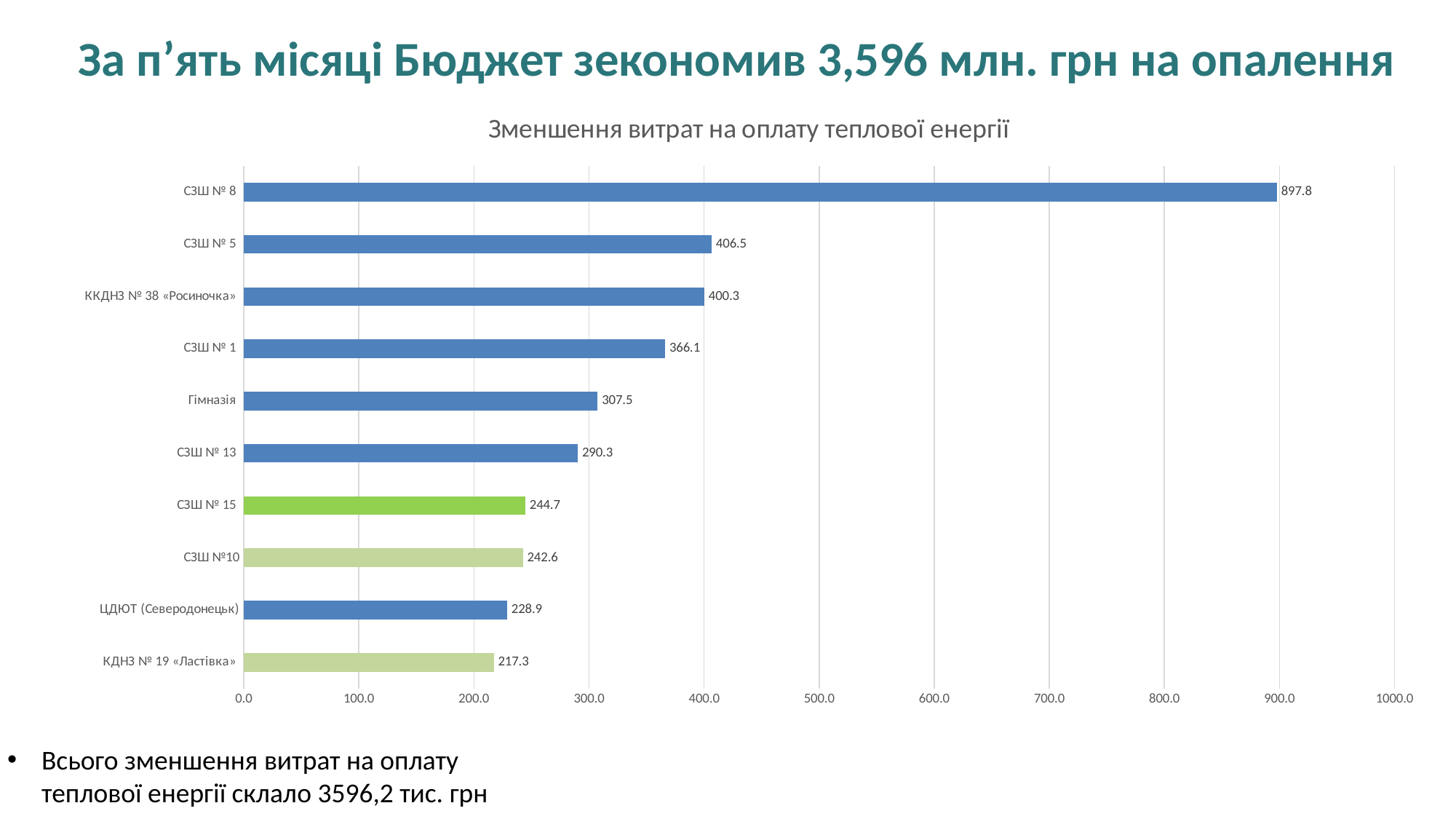
What is the value for ЦДЮТ (Северодонецьк)? 228.9 Is the value for Гімназія greater or less than 400.0? less What kind of chart is shown on the slide? bar chart What is the value for СЗШ № 8? 897.8 What is the title of the chart? Зменшення витрат на оплату теплової енергії Which category has the highest value? СЗШ № 8 What is the difference between the values for СЗШ № 8 and Гімназія? 590.3 What is the difference between the values for СЗШ № 5 and СЗШ № 1? 40.4 Which category has the lowest value? КДНЗ № 19 «Ластівка» How many categories are shown in the chart? 10 Which is larger, the value for СЗШ № 13 or the value for СЗШ № 15? СЗШ № 13 What is the value for ККДНЗ № 38 «Росиночка»? 400.3